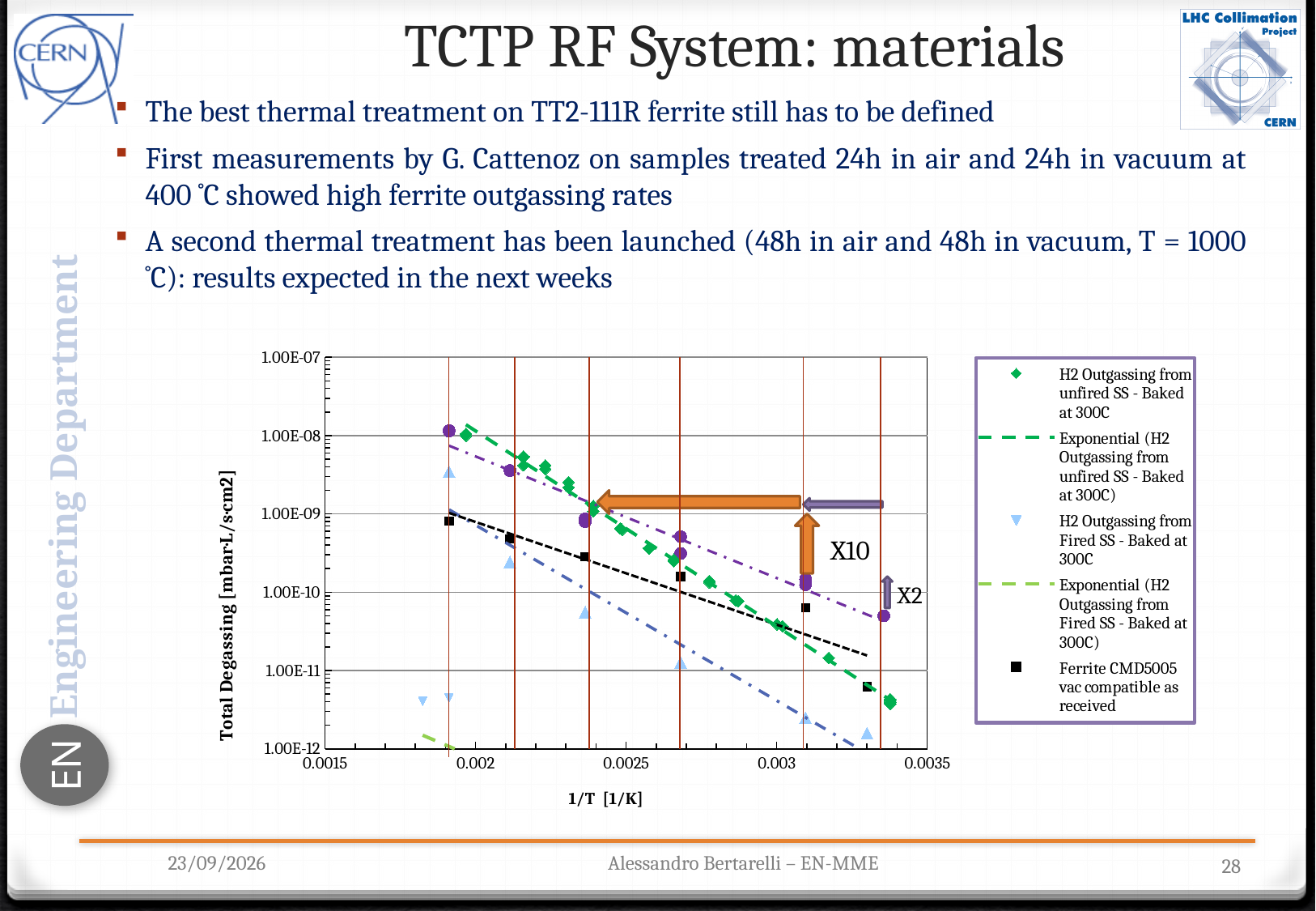
What is the label of the chart's x axis? 1/T [1/K] Near 1/T = 0.0024, which series has the larger value: H2 outgassing from unfired SS (green diamonds) or H2 outgassing from Fired SS (light blue triangles)? H2 Outgassing from unfired SS Is the H2 outgassing value from Fired SS (light blue triangles) near 1/T = 0.0033 greater or less than 1.00E-11? less Do the H2 outgassing values from unfired SS rise or fall as 1/T increases along the x axis? fall Is the H2 outgassing value from unfired SS (green diamonds) near 1/T = 0.002 greater or less than 1.00E-09? greater How many series does the chart legend list? 5 Near 1/T = 0.0031, which series has the larger value: Ferrite CMD5005 (black squares) or H2 outgassing from Fired SS (light blue triangles)? Ferrite CMD5005 What is the lowest value shown on the chart's y axis? 1.00E-12 What is the label of the chart's y axis? Total Degassing [mbar·L/s·cm2] What kind of chart is shown on the slide? scatter chart with trend lines Do the Ferrite CMD5005 values rise or fall as 1/T increases along the x axis? fall Is the Ferrite CMD5005 value near 1/T = 0.0019 greater or less than 1.00E-09? less